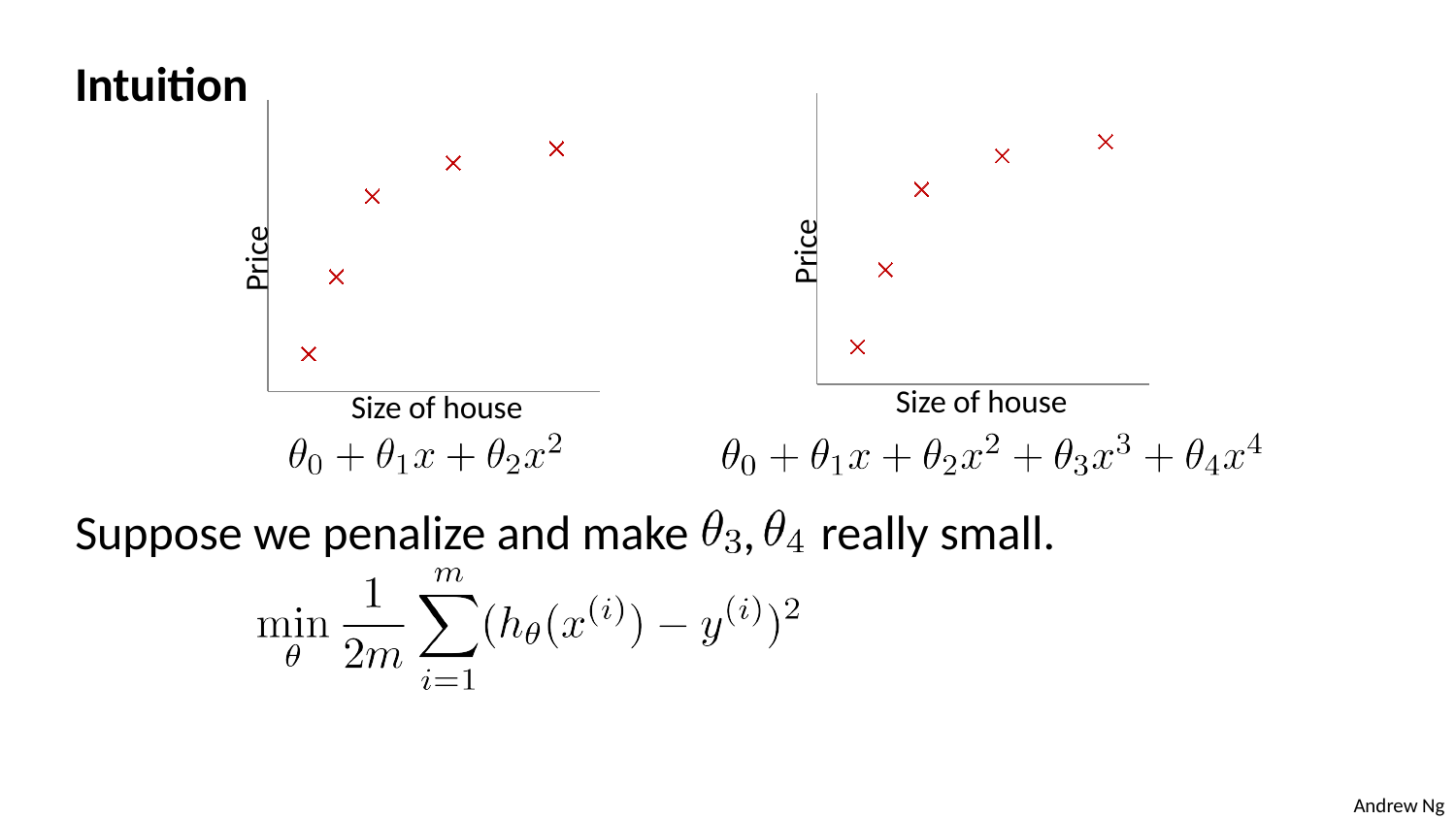
In the left chart, does Price rise or fall as Size of house increases? rise How many data points are plotted in the right chart? 5 What is the y-axis label of the right chart? Price What kind of chart is the left chart on the slide? scatter plot How many charts are shown on the slide? 2 What kind of chart is the right chart on the slide? scatter plot What is the x-axis label of the left chart? Size of house How many data points are plotted in the left chart? 5 In the right chart, does Price rise or fall as Size of house increases? rise